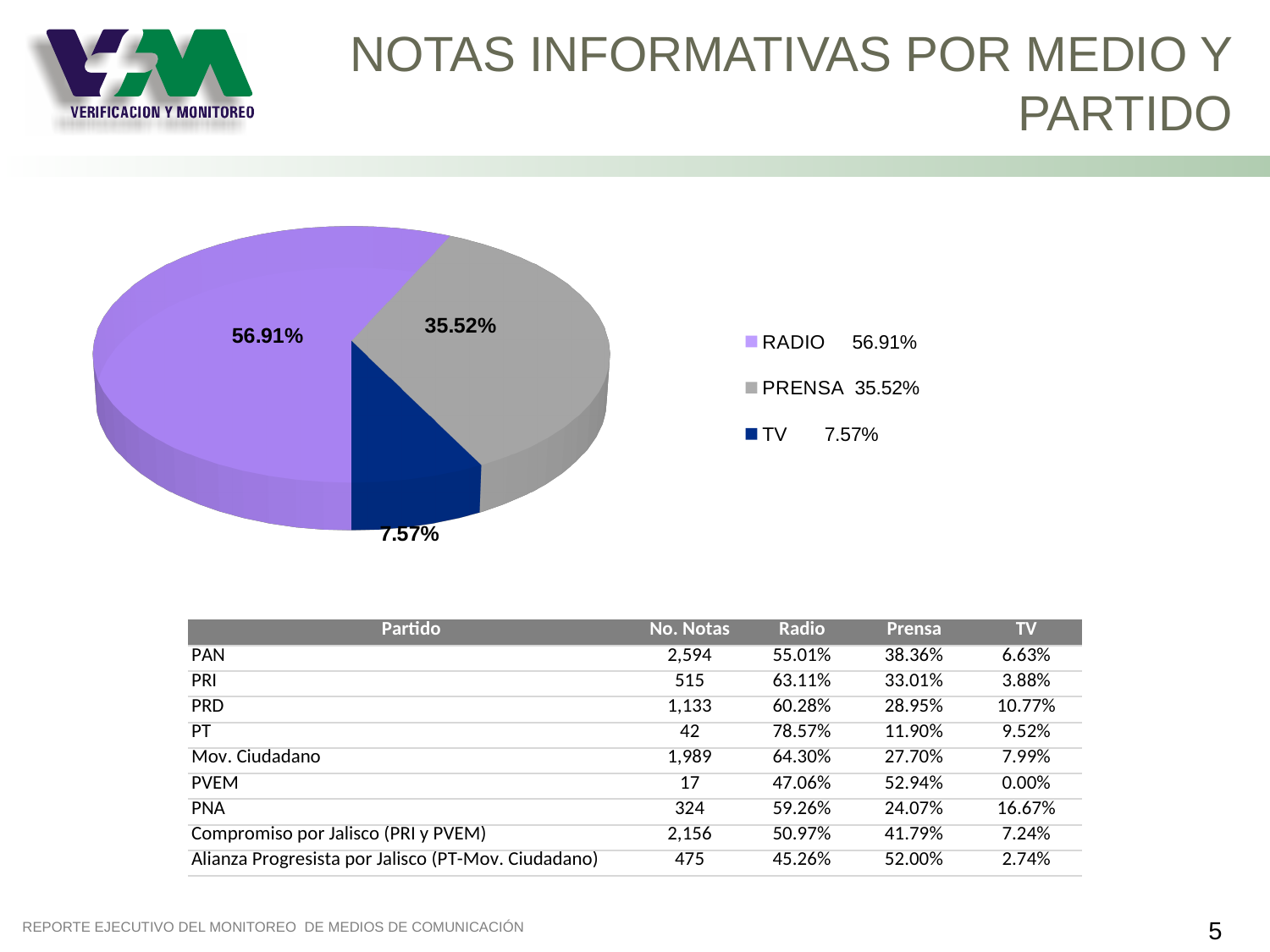
What colour is the TV slice in the pie chart? Dark blue What share of the pie chart does RADIO represent? 56.91% Which medium has the largest slice in the pie chart? RADIO What kind of chart is shown on the slide? Pie chart What is the difference in percentage points between the RADIO and PRENSA slices? 21.39 Which medium has the smallest slice in the pie chart? TV Which slice is larger, PRENSA or TV? PRENSA What share of the pie chart does TV represent? 7.57% How many entries does the legend of the pie chart list? 3 What share of the pie chart does PRENSA represent? 35.52% How many slices does the pie chart have? 3 What is the title of the slide containing the pie chart? NOTAS INFORMATIVAS POR MEDIO Y PARTIDO